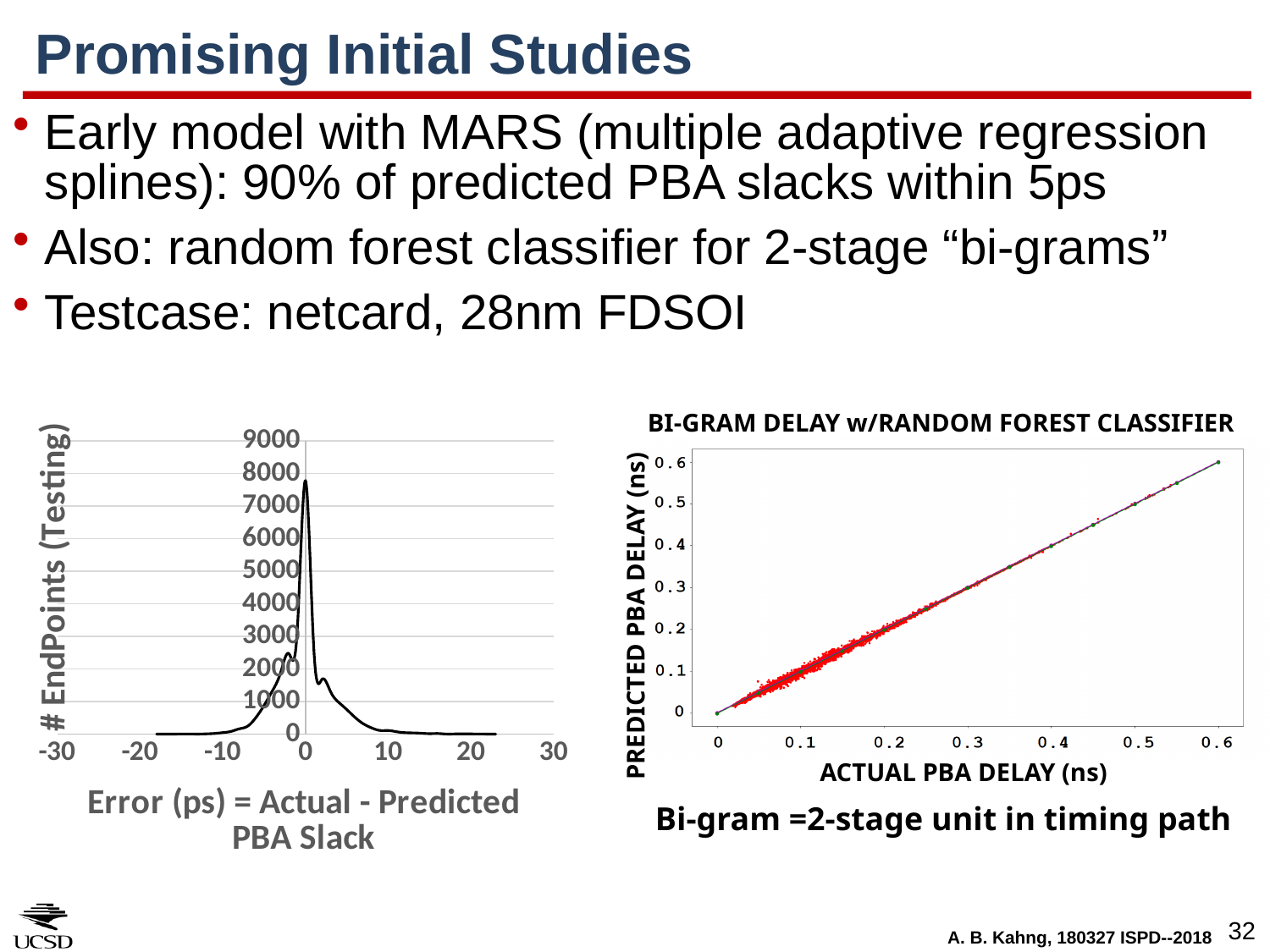
In the left chart, is the peak value of the curve greater or less than 7000? greater What is the title of the right chart? BI-GRAM DELAY w/RANDOM FOREST CLASSIFIER What is the highest tick value shown on the x axis of the right chart? 0.6 In the right chart, does the predicted PBA delay rise or fall as the actual PBA delay increases? rise In the left chart, is the value of the curve at an error of 20 ps greater or less than 1000? less What kind of chart is the left chart (Error (ps) = Actual - Predicted PBA Slack)? line chart In the left chart, is the peak value of the curve greater or less than 8000? less In the left chart, at which x-axis tick value does the curve reach its peak? 0 What kind of chart is the right chart titled BI-GRAM DELAY w/RANDOM FOREST CLASSIFIER? scatter plot What is the x-axis label of the right chart? ACTUAL PBA DELAY (ns)